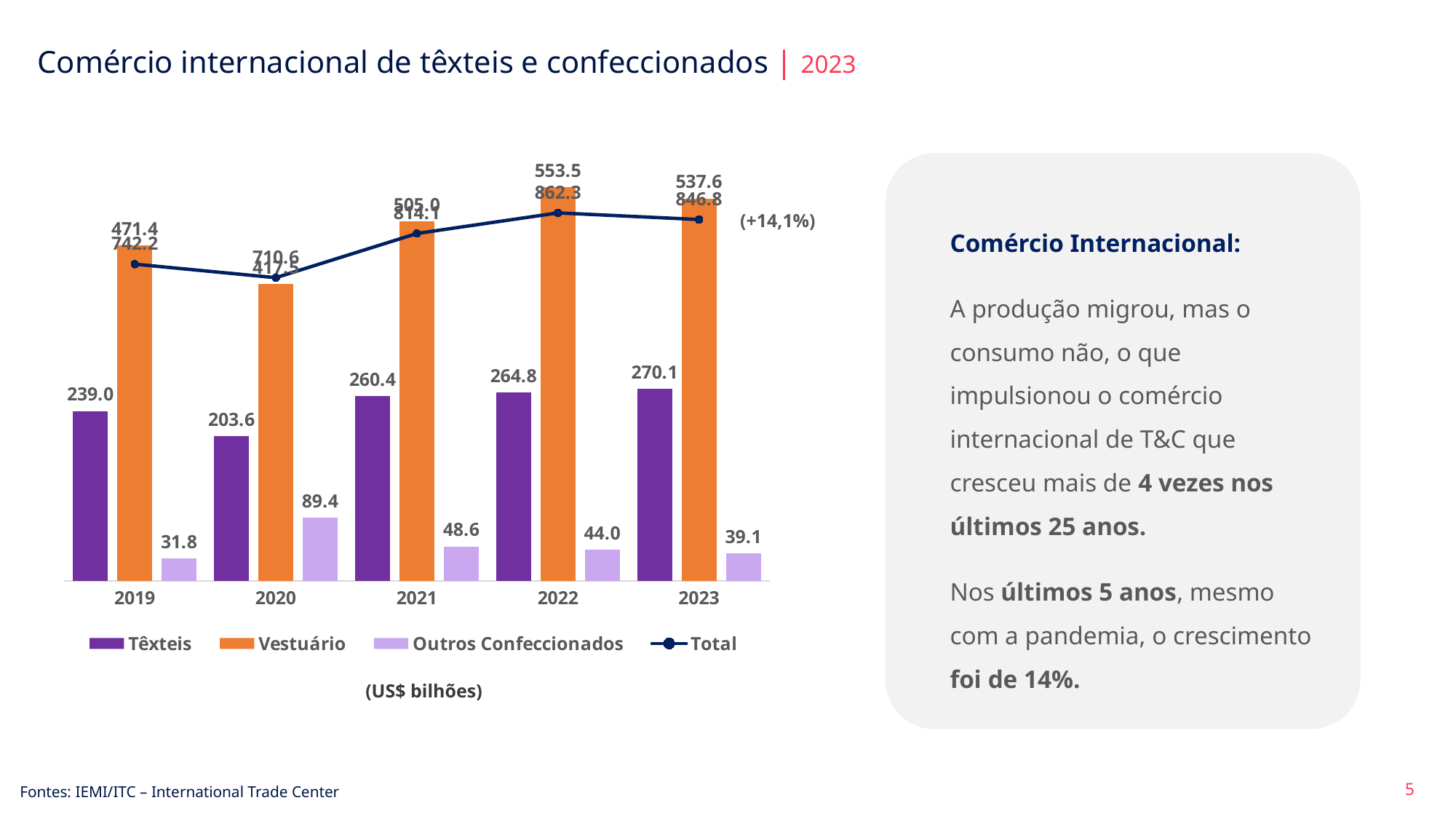
What is the difference between the Têxteis values for 2023 and 2019? 31.1 How many years are shown on the x axis? 5 What is the value for Têxteis in 2023? 270.1 What is the value for Vestuário in 2020? 417.5 How many series does the legend list? 4 In which year is the Têxteis value lowest? 2020 What is the value for Outros Confeccionados in 2020? 89.4 What kind of chart is shown on the slide? Bar chart with a line series In which year is the Total highest? 2022 What is the Total value in 2022? 862.3 Which year has the larger Vestuário value, 2022 or 2023? 2022 Does the Têxteis value rise or fall from 2020 to 2023? Rise